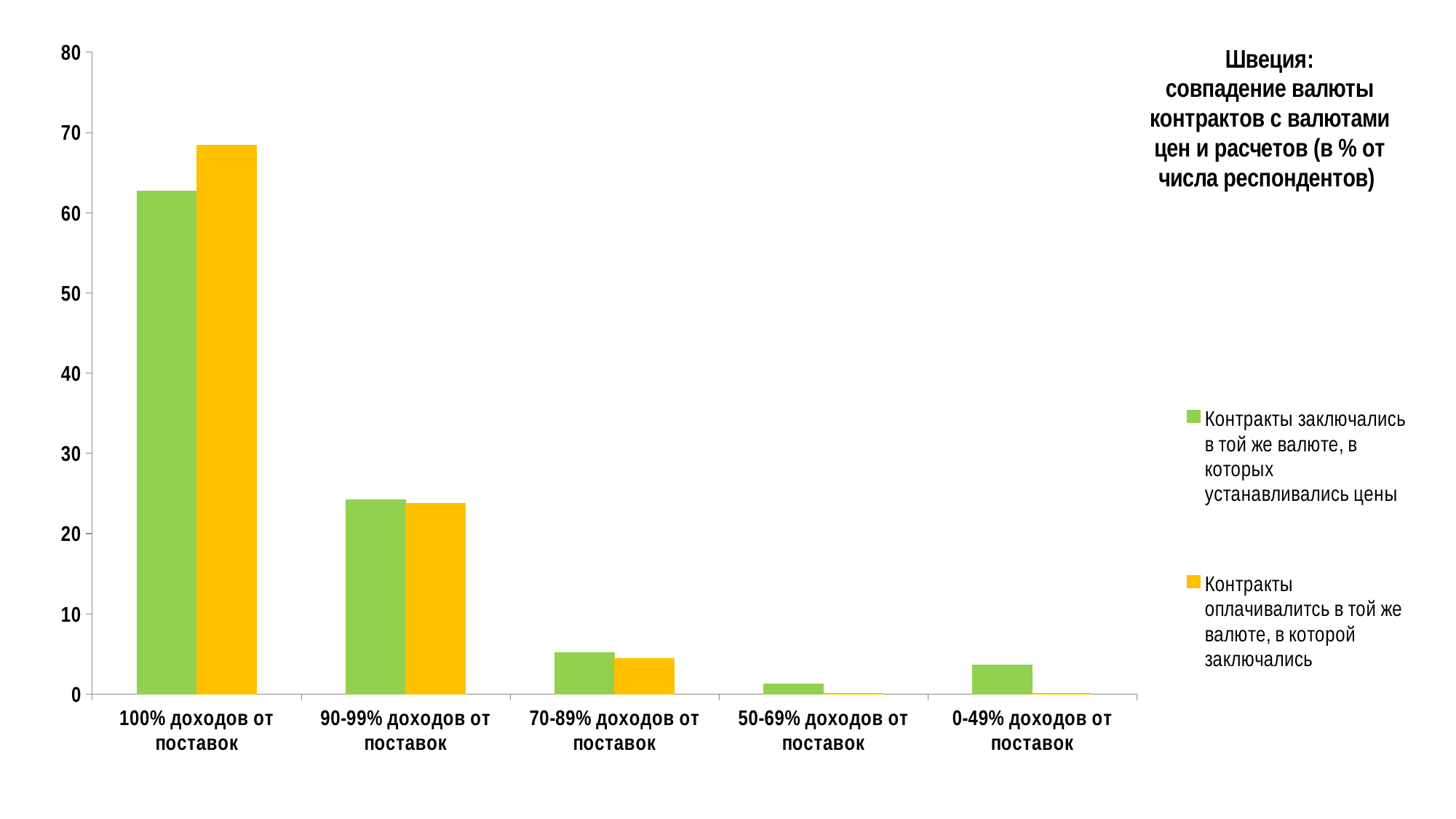
Is the value for "70-89% доходов от поставок" in the series "Контракты заключались в той же валюте, в которых устанавливались цены" greater or less than 10? less For the category "0-49% доходов от поставок", which series has the larger value? Контракты заключались в той же валюте, в которых устанавливались цены Which country is named in the chart title? Швеция Is the value for "100% доходов от поставок" in the series "Контракты заключались в той же валюте, в которых устанавливались цены" greater or less than 60? greater How many categories are shown on the x axis? 5 For the category "100% доходов от поставок", which series has the larger value? Контракты оплачивалитсь в той же валюте, в которой заключались Is the value for "90-99% доходов от поставок" in the series "Контракты заключались в той же валюте, в которых устанавливались цены" greater or less than 20? greater How many series does the legend list? 2 Which category has the highest value for the series "Контракты оплачивалитсь в той же валюте, в которой заключались"? 100% доходов от поставок What kind of chart is shown on the slide? bar chart Which category has the highest value for the series "Контракты заключались в той же валюте, в которых устанавливались цены"? 100% доходов от поставок